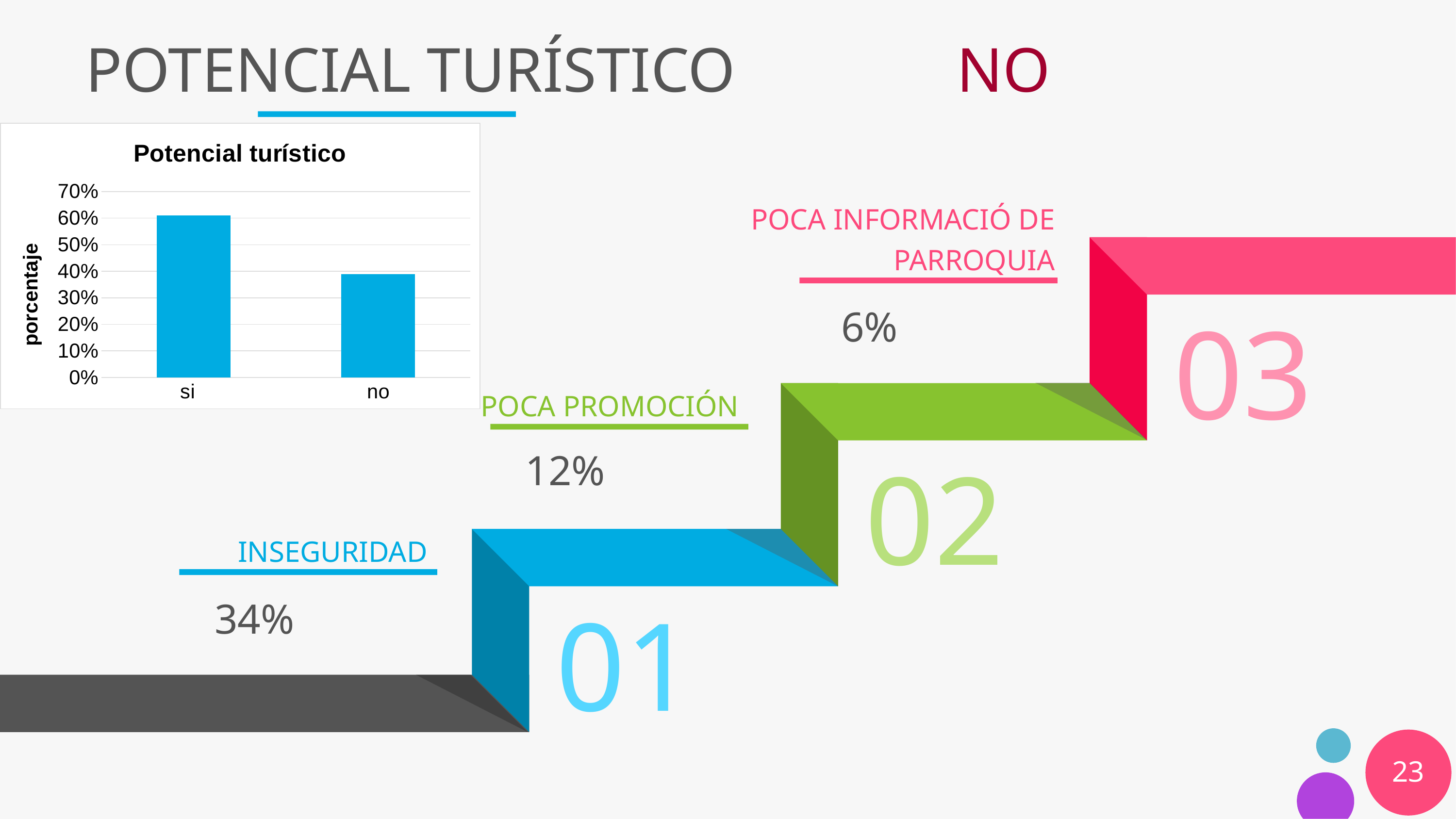
Which is larger, the value for si or the value for no? si How many categories are plotted in the chart? 2 What kind of chart is shown on the slide? bar chart What is the label on the vertical axis of the chart? porcentaje Is the value for no greater or less than 50%? less Which category has the highest value in the chart? si Is the value for no greater or less than 30%? greater Which category has the lowest value in the chart? no Do the values rise or fall from si to no along the x axis? fall Is the value for si greater or less than 50%? greater What is the title of the chart? Potencial turístico